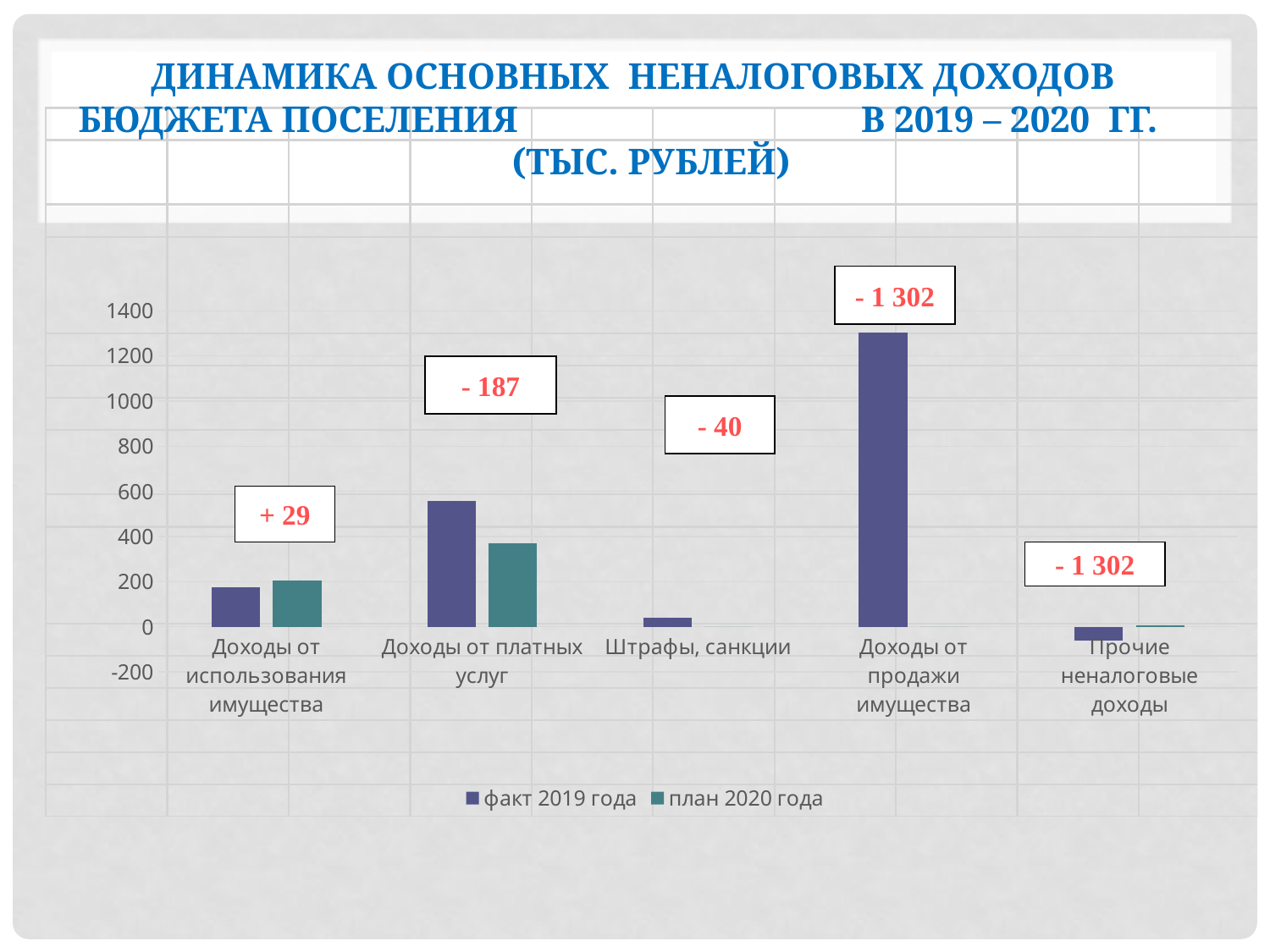
Which category has the highest value for факт 2019 года? Доходы от продажи имущества Is the факт 2019 года value for Доходы от платных услуг greater or less than 400? greater How many series does the legend list? 2 Is the план 2020 года value for Доходы от использования имущества greater or less than 100? greater Is the факт 2019 года value for Доходы от продажи имущества greater or less than 1200? greater How many categories are shown on the x axis? 5 What kind of chart is shown on the slide? bar chart What change is written in the box above the bars for Доходы от платных услуг? - 187 For Доходы от платных услуг, which series has the larger value: факт 2019 года or план 2020 года? факт 2019 года For Доходы от использования имущества, which series has the larger value: факт 2019 года or план 2020 года? план 2020 года Which category has the lowest value for факт 2019 года? Прочие неналоговые доходы